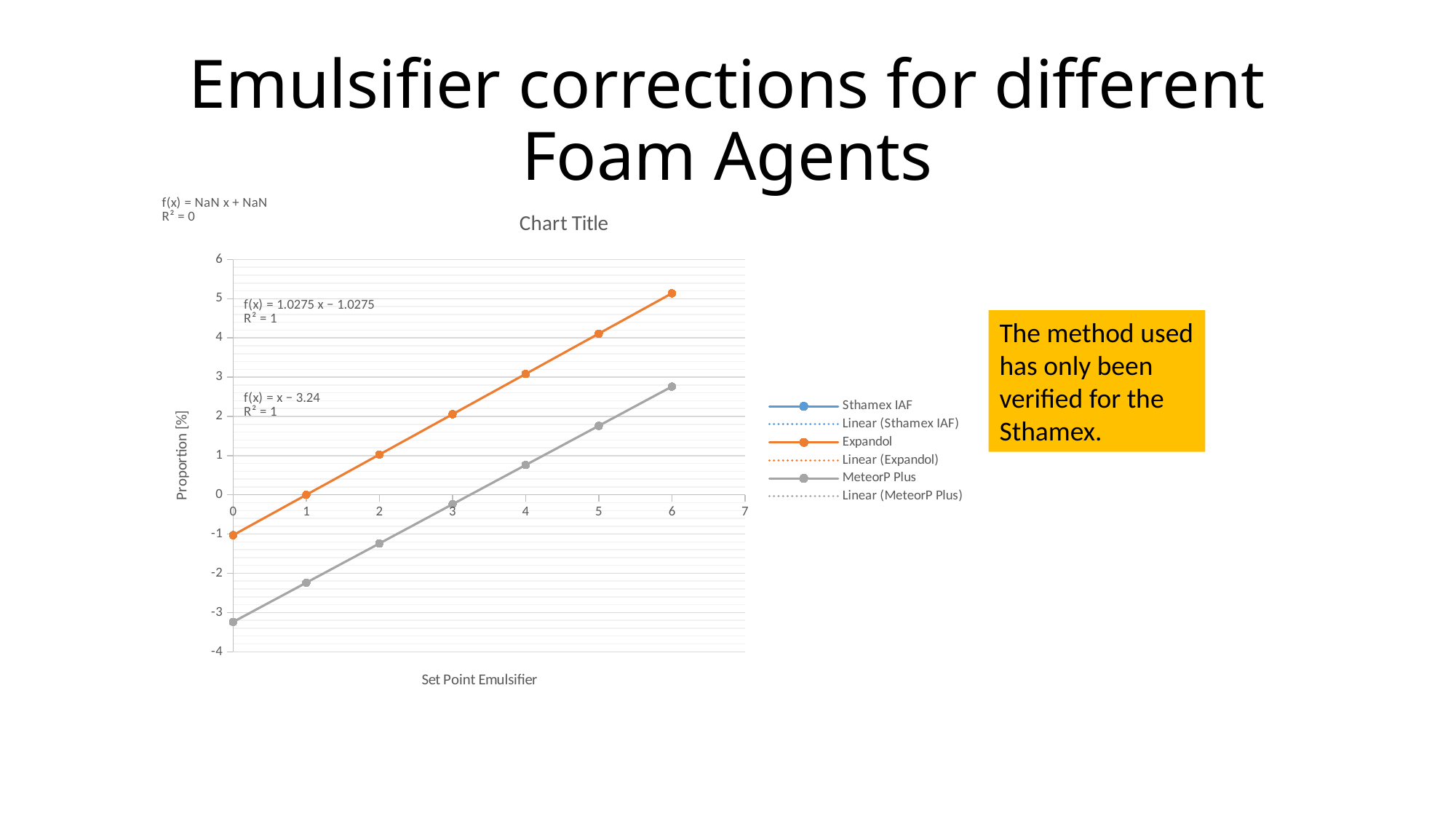
Is the value for MeteorP Plus at set point emulsifier 6 greater or less than 3? less What trendline equation is shown for the MeteorP Plus series? f(x) = x − 3.24 Do the values of the MeteorP Plus series rise or fall as the set point emulsifier increases? rise Is the value for Expandol at set point emulsifier 6 greater or less than 5? greater How many data points are plotted for the Expandol series? 7 What kind of chart is shown on the slide? line chart Is the value for MeteorP Plus at set point emulsifier 0 greater or less than -3? less What is the value of the Expandol series at set point emulsifier 1? 0 What R² value is shown for the Expandol trendline? 1 At set point emulsifier 4, which series has the larger value, Expandol or MeteorP Plus? Expandol How many entries does the chart legend list? 6